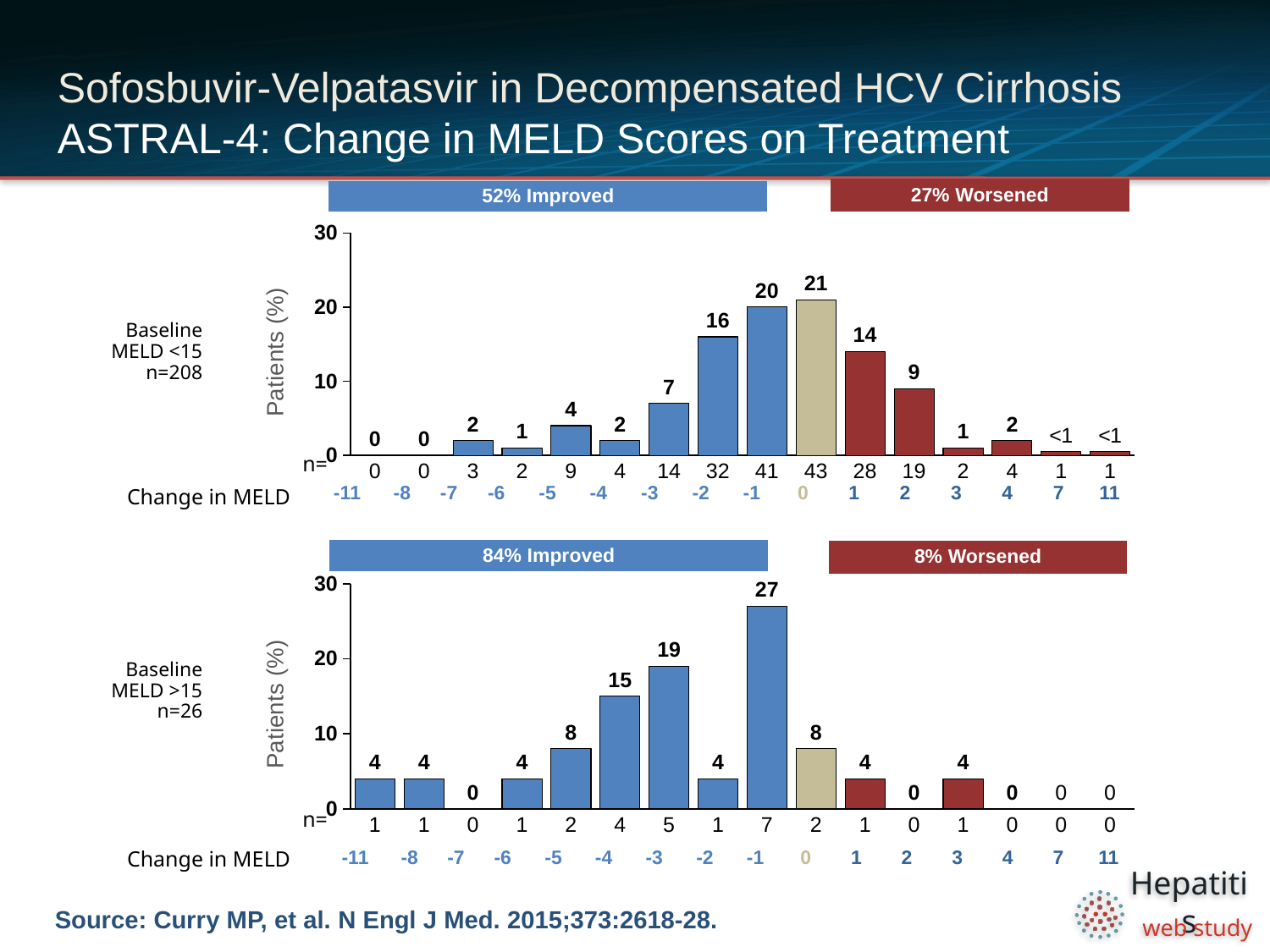
What type of chart is used for the Baseline MELD <15 data? Bar chart In the bottom chart (Baseline MELD >15), what is the difference in percentage of patients between a change in MELD of -3 and a change of -5? 11 In the top chart (Baseline MELD <15), what percentage of patients had a change in MELD of -1? 20 In the top chart (Baseline MELD <15), what percentage of patients had a change in MELD of 0? 21 In the bottom chart (Baseline MELD >15), what percentage of patients had a change in MELD of -1? 27 How many change in MELD categories are shown on the x axis of the bottom chart (Baseline MELD >15)? 16 In the top chart (Baseline MELD <15), what is the difference in percentage of patients between a change in MELD of -2 and a change of +2? 7 In the bottom chart (Baseline MELD >15), what percentage of patients had a change in MELD of -4? 15 According to the banner above the bottom chart (Baseline MELD >15), what percentage of patients improved? 84% Improved In the top chart (Baseline MELD <15), which change in MELD category has the highest percentage of patients? 0 In the top chart (Baseline MELD <15), which has a higher percentage of patients: a change in MELD of +1 or a change of +2? +1 In the bottom chart (Baseline MELD >15), which change in MELD category has the highest percentage of patients? -1